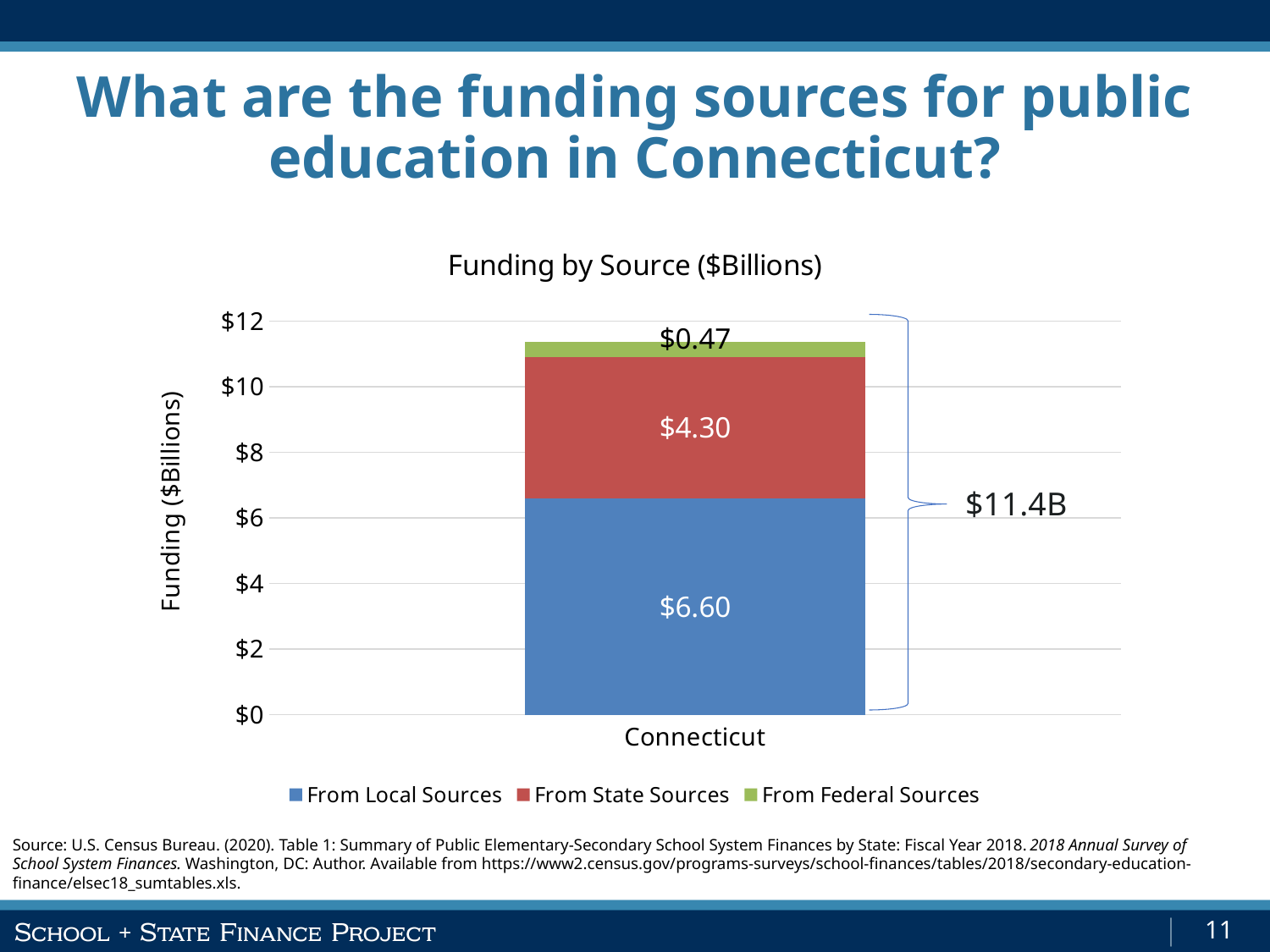
What is the label on the vertical axis of the chart? Funding ($Billions) What kind of chart is shown on the slide? Stacked bar chart How many series does the legend list? 3 Which funding source has the highest value in the chart? From Local Sources What is the value for From State Sources in the Funding by Source chart? $4.30 What is the title of the chart? Funding by Source ($Billions) What is the difference between the From Local Sources value and the From State Sources value? $2.30 What is the value for From Local Sources in the Funding by Source chart? $6.60 What is the total of the stacked bar for Connecticut as labelled on the slide? $11.4B Which funding source has the lowest value in the chart? From Federal Sources What is the value for From Federal Sources in the Funding by Source chart? $0.47 Which is larger, the value for From State Sources or the value for From Federal Sources? From State Sources